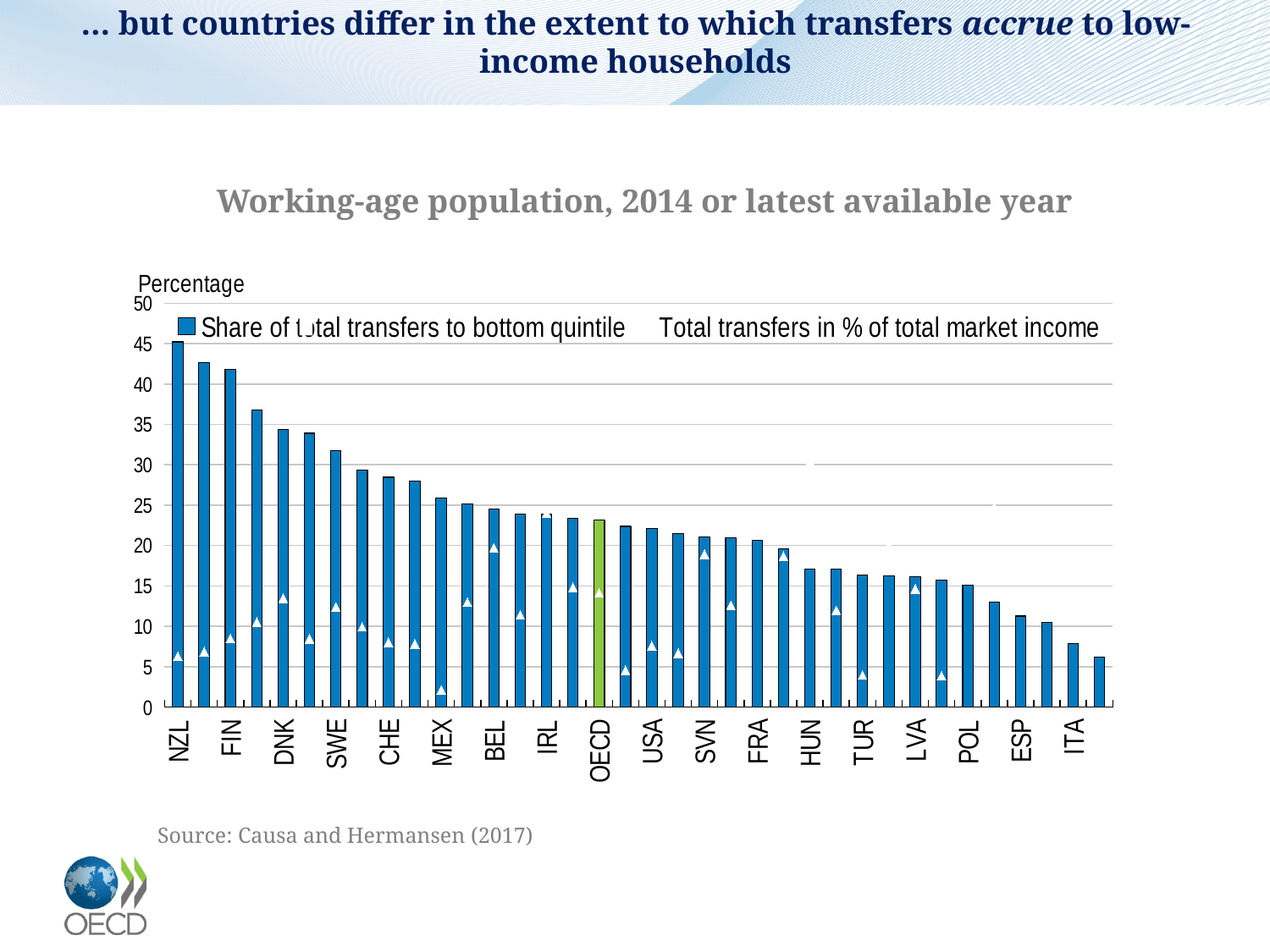
Is the share of total transfers to bottom quintile for ITA greater or less than 10? less Do the bars for share of total transfers to bottom quintile rise or fall from left to right along the x axis? fall Is the share of total transfers to bottom quintile for NZL greater or less than 40? greater Is the total transfers in % of total market income marker for MEX greater or less than 5? less Which has a larger share of total transfers to bottom quintile, NZL or DNK? NZL What kind of chart is shown on the slide? bar chart How many series does the legend list? 2 What colour is the OECD bar in the chart? green Which has a larger share of total transfers to bottom quintile, USA or POL? USA What is the title of the chart? Working-age population, 2014 or latest available year Which country has the highest bar for share of total transfers to bottom quintile? NZL